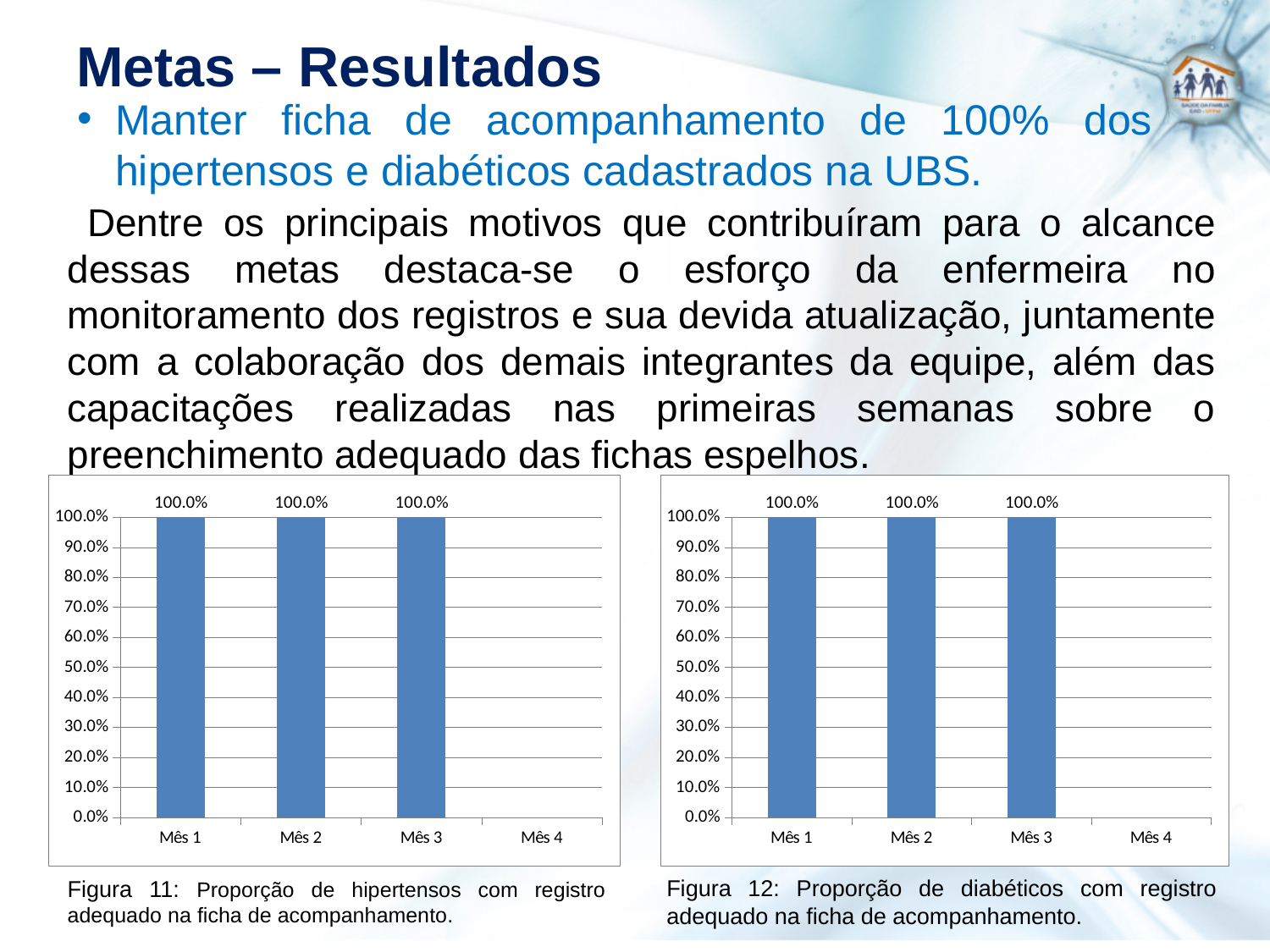
How many categories are shown on the x axis of the right chart (Figura 12)? 4 What kind of chart is the right chart (Figura 12)? bar chart In the right chart (Figura 12), what is the value for Mês 3? 100.0% In the left chart (Figura 11), is the value for Mês 2 greater or less than 50.0%? greater In the left chart (Figura 11), what is the difference between the values for Mês 1 and Mês 2? 0.0% What kind of chart is the left chart (Figura 11)? bar chart In the right chart (Figura 12), what is the value for Mês 2? 100.0% In the left chart (Figura 11), what is the value for Mês 1? 100.0% How many categories are shown on the x axis of the left chart (Figura 11)? 4 In the left chart (Figura 11), what is the value for Mês 3? 100.0% Which category in the right chart (Figura 12) has no bar plotted? Mês 4 In the right chart (Figura 12), is the value for Mês 1 greater or less than 90.0%? greater